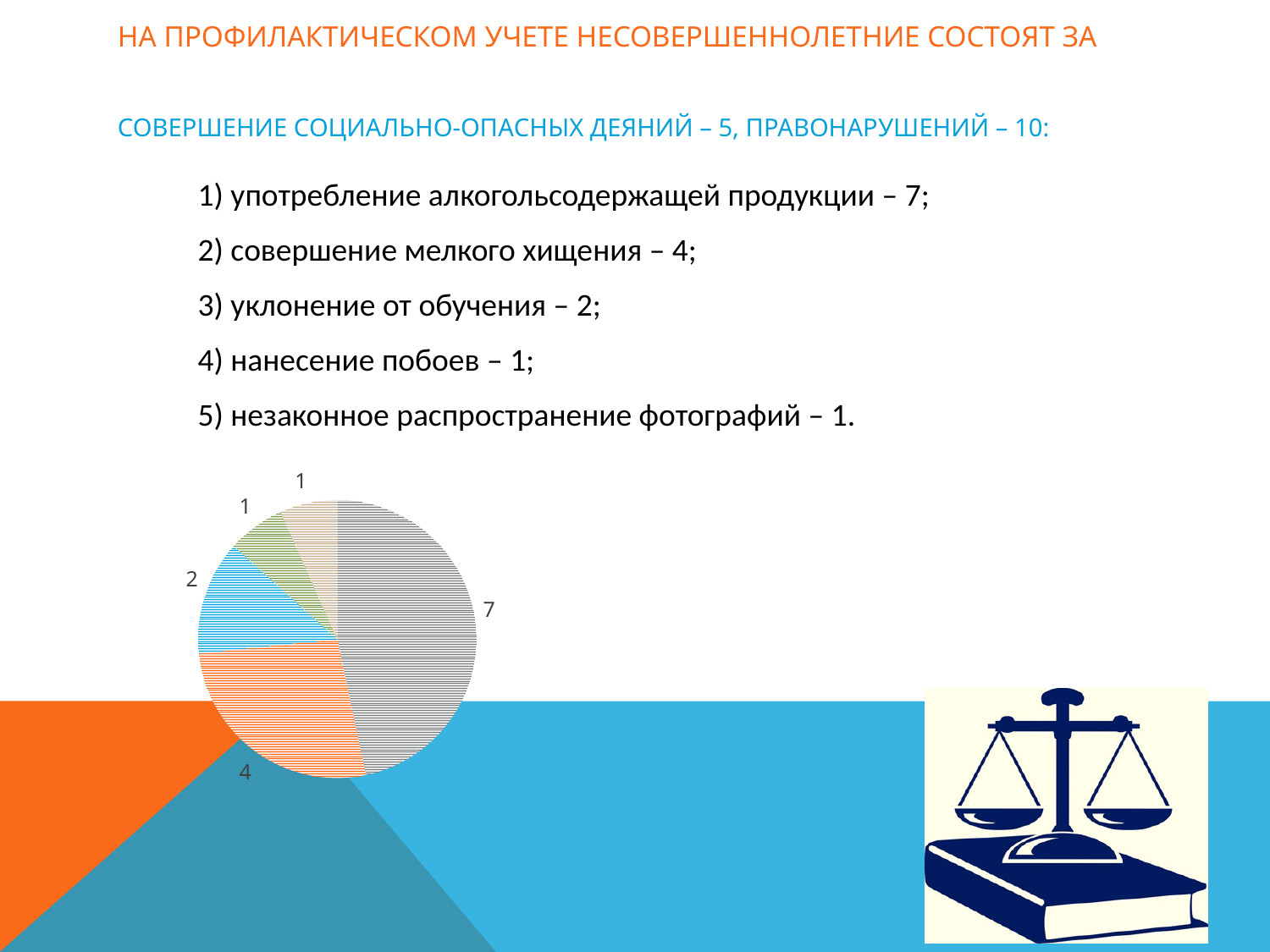
What value is labelled on the orange slice of the pie chart? 4 What is the value of the largest slice in the pie chart? 7 How many slices does the pie chart have? 5 Which is larger in the pie chart: the orange slice or the blue slice? the orange slice What is the total of all slice values in the pie chart? 15 What is the difference between the largest slice (7) and the second-largest slice (4) in the pie chart? 3 What is the value of the smallest slice in the pie chart? 1 What kind of chart is shown on the slide? pie chart Does the pie chart have a legend? No How many slices in the pie chart are labelled with the value 1? 2 What is the difference between the slice labelled 4 and the slice labelled 2 in the pie chart? 2 What value is labelled on the blue slice of the pie chart? 2